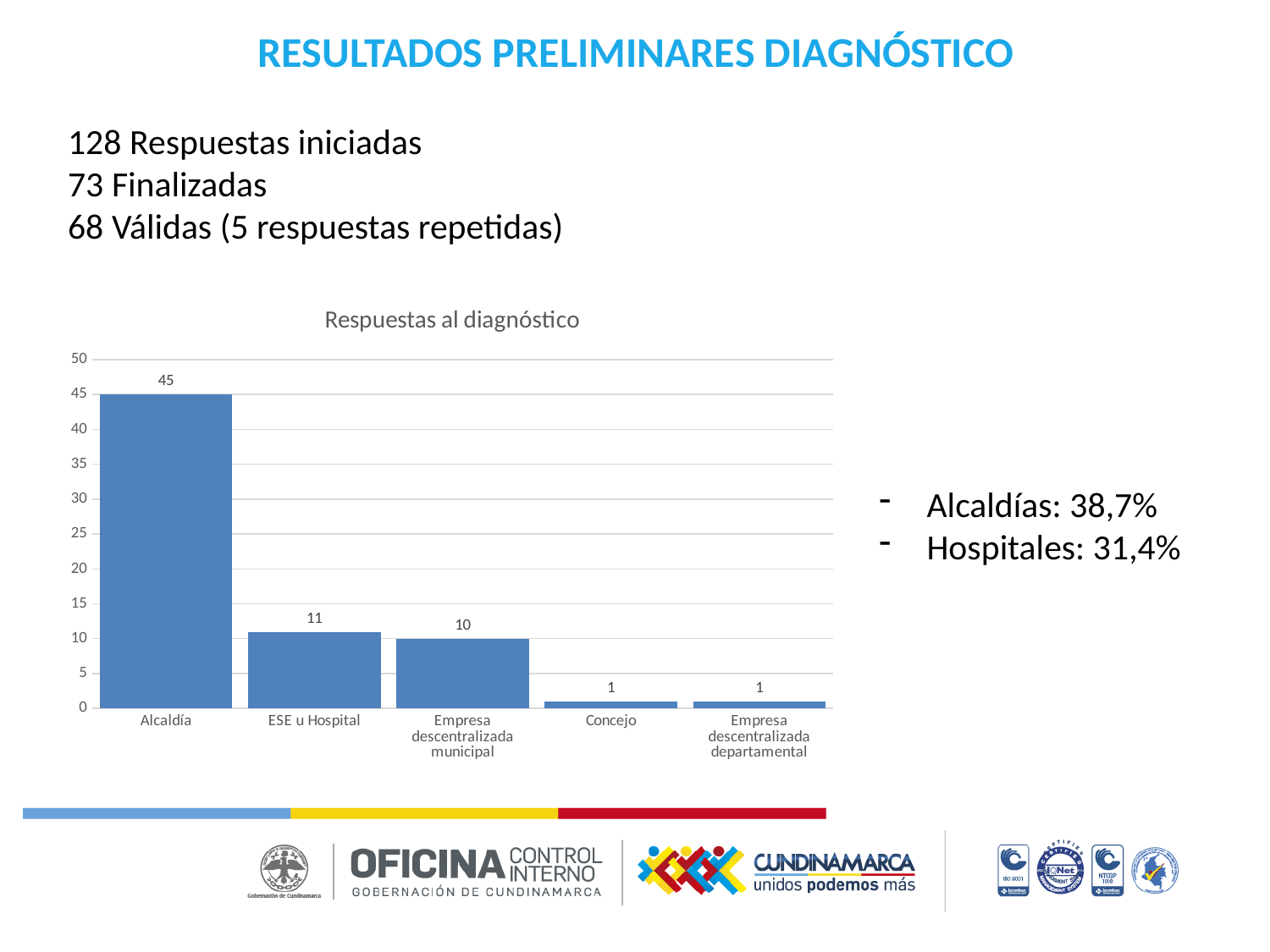
What is the title of the chart? Respuestas al diagnóstico What is the value for Concejo in the chart? 1 Is the value for Alcaldía greater or less than 40? greater Which is larger, the value for Alcaldía or the value for Empresa descentralizada municipal? Alcaldía What is the difference between the values for Alcaldía and ESE u Hospital? 34 What is the value for Alcaldía in the chart? 45 What kind of chart is shown on the slide? Bar chart What is the value for ESE u Hospital in the chart? 11 What is the difference between the values for ESE u Hospital and Empresa descentralizada municipal? 1 Which category has the highest value in the chart? Alcaldía How many categories are shown in the chart? 5 What is the value for Empresa descentralizada municipal in the chart? 10